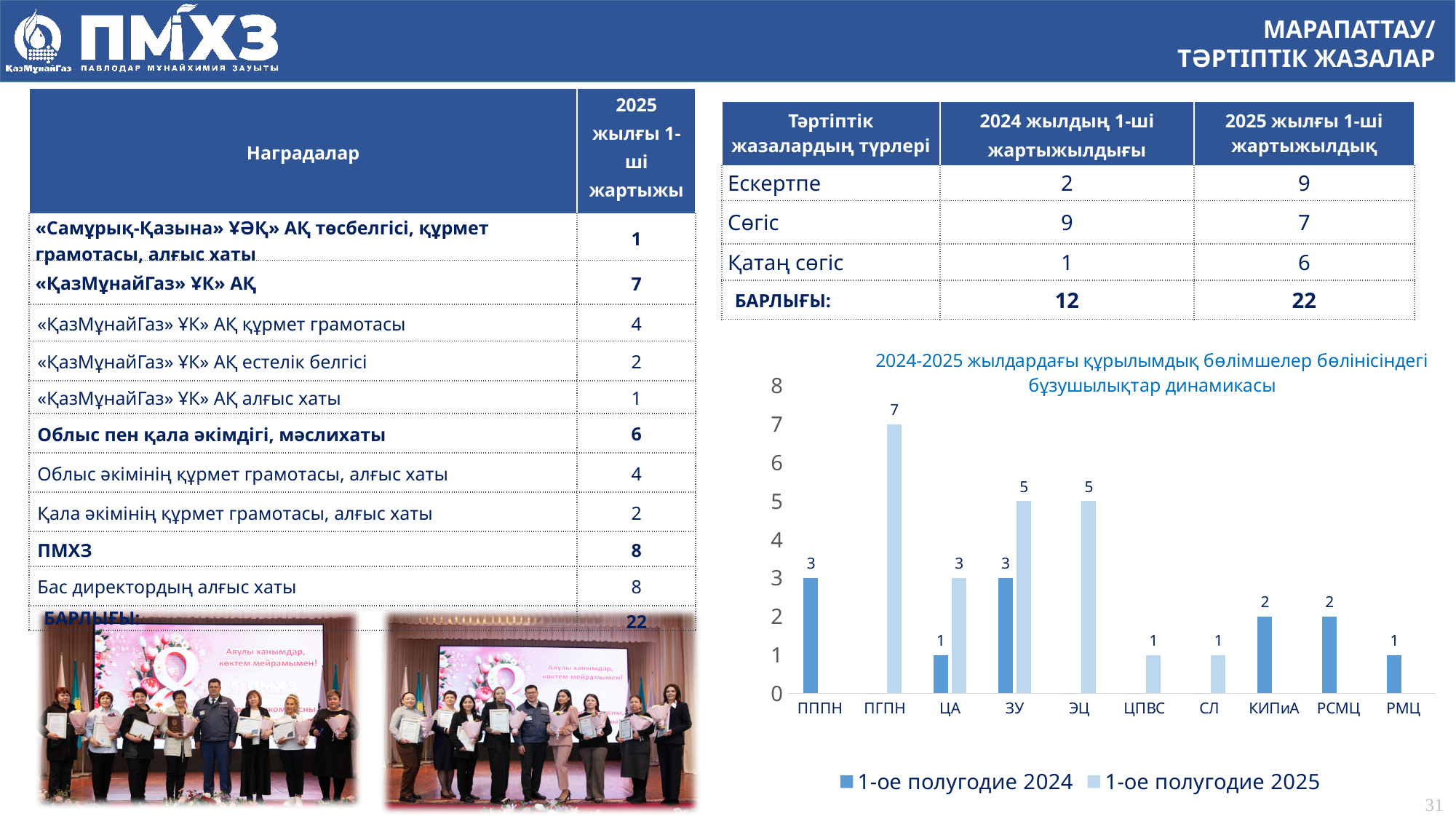
What is the value for ПГПН in the 1-ое полугодие 2025 series? 7 What is the value for ЗУ in the 1-ое полугодие 2025 series? 5 How many categories are shown on the x axis of the chart? 10 Which series is shown in the darker blue colour in the chart? 1-ое полугодие 2024 What is the value for ПППН in the 1-ое полугодие 2024 series? 3 How many series does the chart legend list? 2 Which category has the highest bar in the chart? ПГПН What type of chart is shown on the slide? bar chart Which is larger for ЗУ: the 1-ое полугодие 2024 value or the 1-ое полугодие 2025 value? 1-ое полугодие 2025 What is the difference between the 1-ое полугодие 2025 and 1-ое полугодие 2024 values for ЦА? 2 What is the value for КИПиА in the 1-ое полугодие 2024 series? 2 What is the value for ЭЦ in the 1-ое полугодие 2025 series? 5